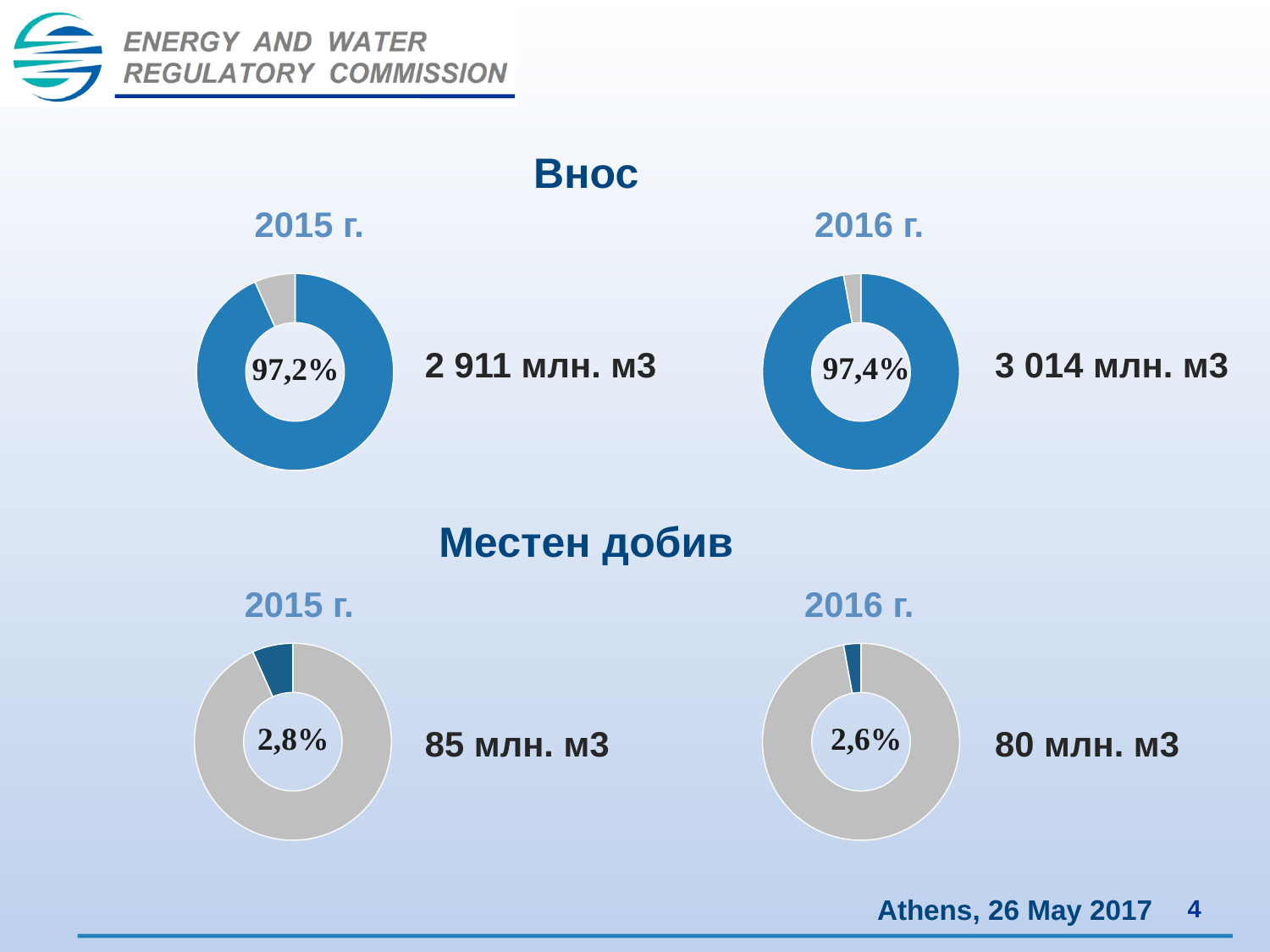
What volume is printed next to the "Внос" 2016 г. chart? 3 014 млн. м3 What volume is printed next to the "Внос" 2015 г. chart? 2 911 млн. м3 In the "Внос" 2015 г. donut chart, what percentage is shown in the centre? 97,2% What kind of chart is used for the "Внос" 2015 г. data? Donut (pie) chart What volume is printed next to the "Местен добив" 2016 г. chart? 80 млн. м3 Which year has the larger share in the "Местен добив" charts, 2015 г. or 2016 г.? 2015 г. In the "Местен добив" 2015 г. donut chart, what percentage is shown in the centre? 2,8% What volume is printed next to the "Местен добив" 2015 г. chart? 85 млн. м3 How many donut charts are shown on the slide? 4 Which year has the larger share in the "Внос" charts, 2015 г. or 2016 г.? 2016 г. In the "Внос" 2016 г. donut chart, what percentage is shown in the centre? 97,4% In the "Местен добив" 2016 г. donut chart, what percentage is shown in the centre? 2,6%